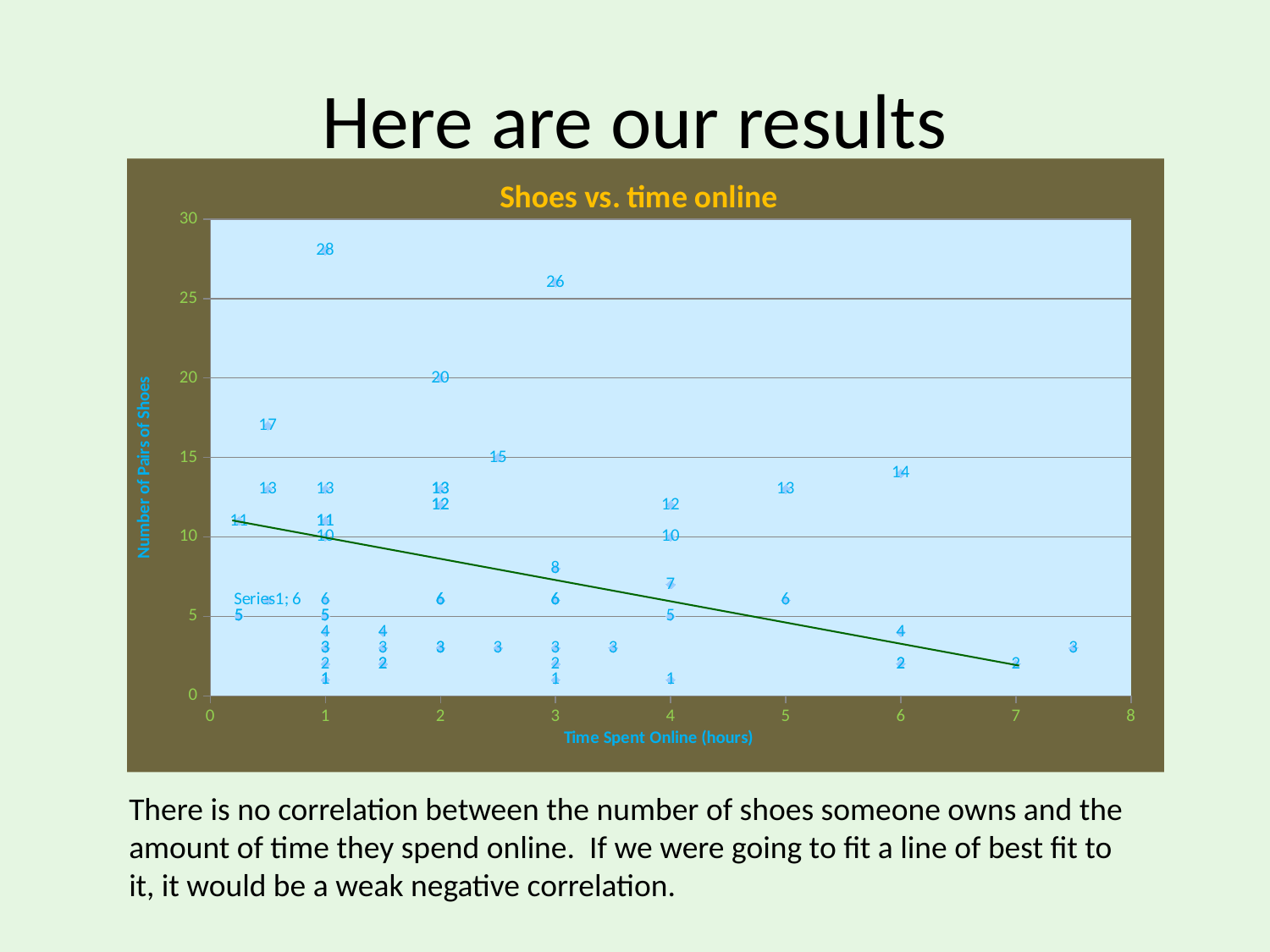
What is the label on the x axis of the chart? Time Spent Online (hours) What kind of chart is shown on the slide? scatter chart What is the difference between the two highest labelled values on the chart, 28 and 26? 2 Is the value of the point at 6 hours spent online labelled 14 greater or less than 10? greater Does the trend line on the chart rise or fall as time spent online increases? fall What is the lowest number of pairs of shoes labelled on the chart? 1 Which is larger: the highest point at 1 hour online (28) or the highest point at 3 hours online (26)? 28 at 1 hour What is the data label of the point at 3 hours spent online that lies above 25 on the y axis? 26 What is the data label of the point at 6 hours spent online that lies between 10 and 15 on the y axis? 14 Is the value of the point at 7 hours spent online greater or less than 5? less What is the title of the chart? Shoes vs. time online What is the highest number of pairs of shoes labelled on the chart? 28